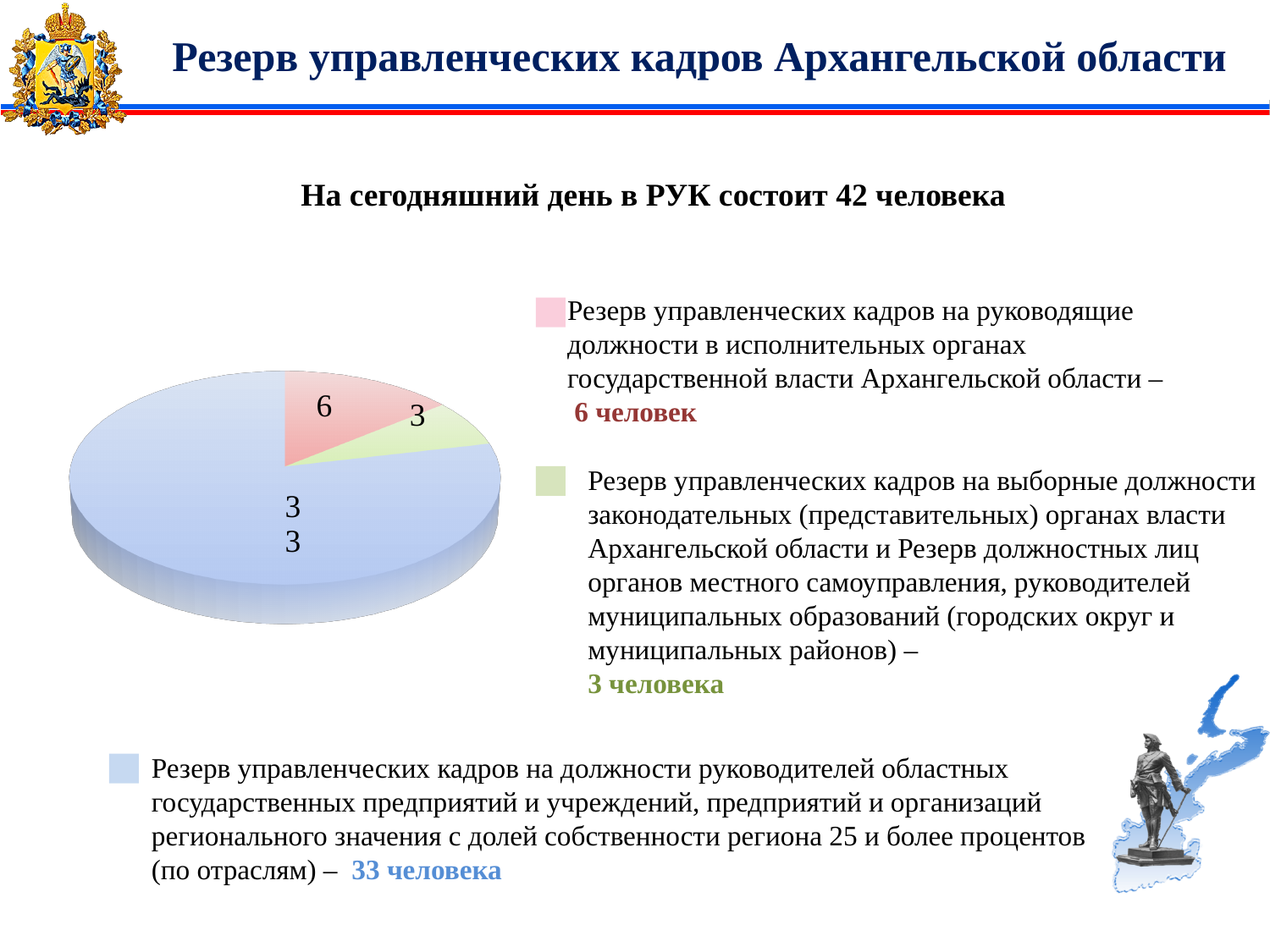
What is the difference between the pink slice (6) and the green slice (3)? 3 What is the total of all slices in the pie chart? 42 What value is shown for the pink slice (reserve for leadership positions in executive bodies of state power of the Arkhangelsk region)? 6 Which is larger: the pink slice for executive bodies or the green slice for elective positions? The pink slice (executive bodies) What value is shown for the green slice (reserve for elective positions in legislative bodies and local self-government officials)? 3 What kind of chart is shown on the slide? Pie chart What value is shown for the blue slice (reserve for heads of regional state enterprises and institutions)? 33 How many slices does the pie chart have? 3 Which category has the smallest slice in the pie chart? Reserve for elective positions in legislative bodies and local self-government officials (3 people) What colour is the largest slice of the pie chart? Light blue What is the difference between the blue slice (33) and the pink slice (6)? 27 Which category has the largest slice in the pie chart? Reserve for heads of regional state enterprises and institutions (33 people)